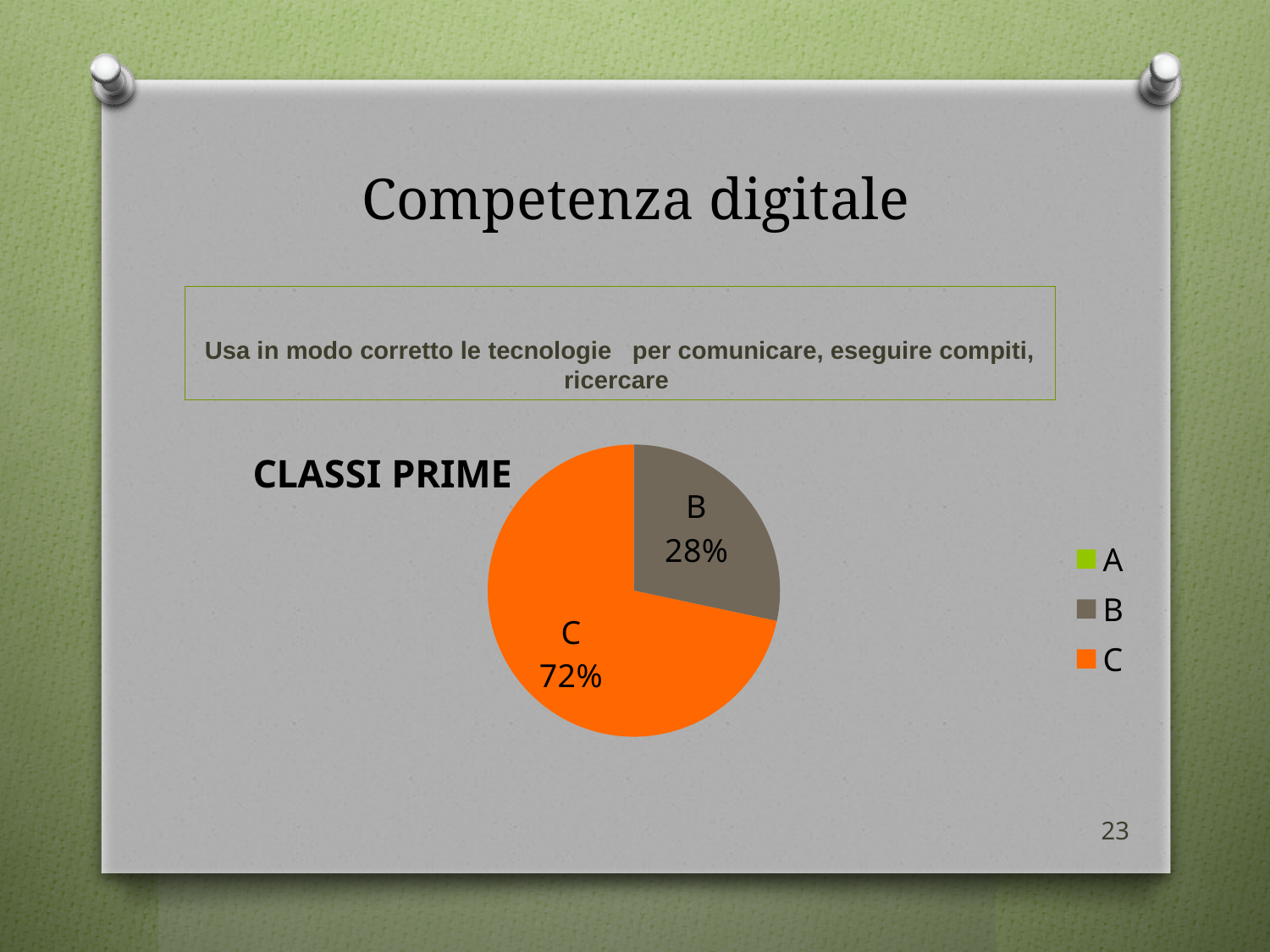
Which of the two visible slices, B or C, is larger? C What kind of chart is shown on the slide? pie chart What is the difference between the values for C and B? 44% What is the value for slice B in the pie chart? 28% What share of the pie does slice C represent? 72% What is the title of the chart? CLASSI PRIME What colour is slice C in the pie chart? orange How many slices are visible in the pie chart? 2 What is the value for slice C in the pie chart? 72% Which slice of the pie chart is the largest? C How many entries does the legend list? 3